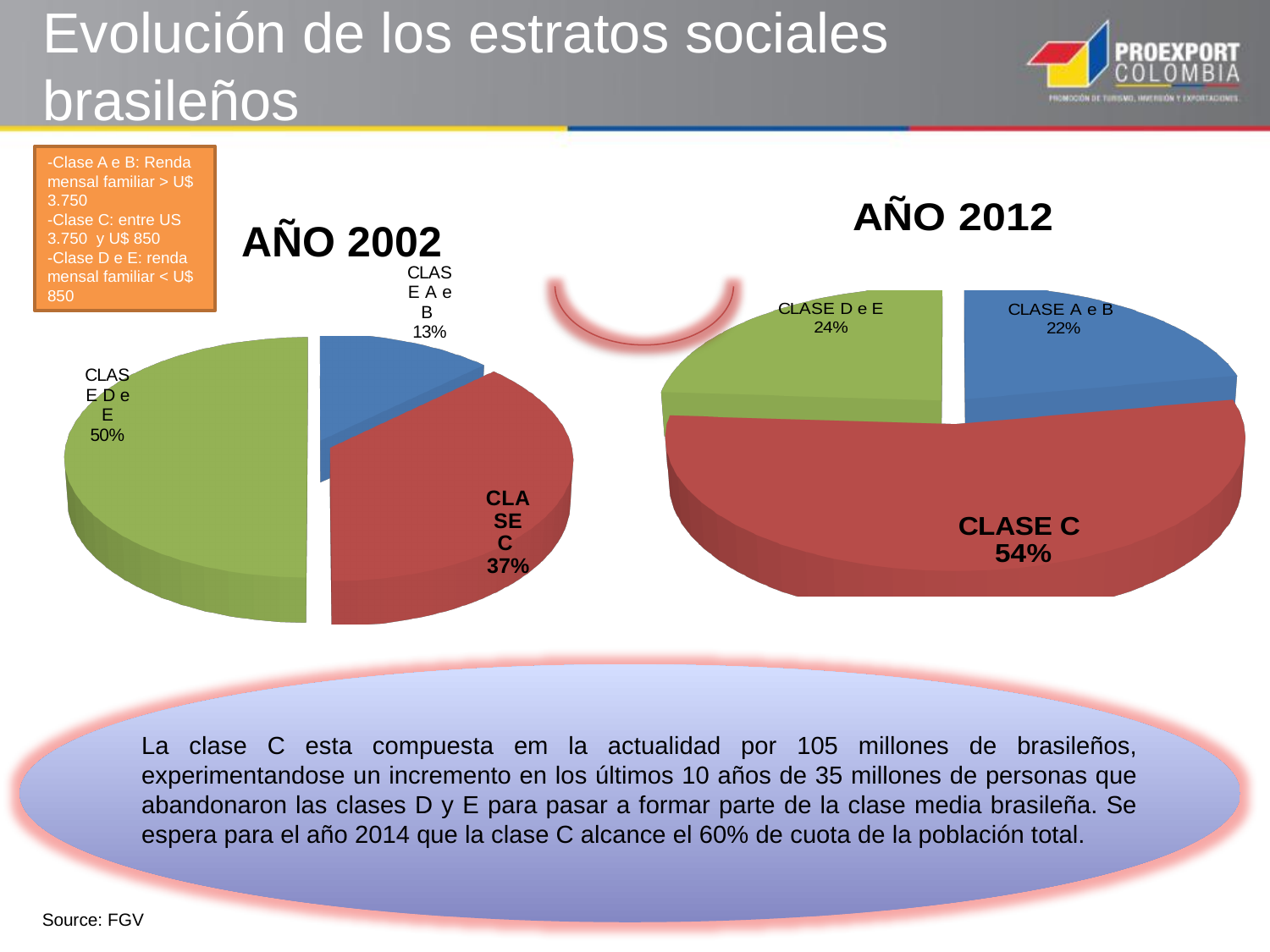
What is the difference in percentage points between the CLASE C share in the AÑO 2012 chart and in the AÑO 2002 chart? 17 In the AÑO 2002 pie chart, what share does CLASE C have? 37% In the AÑO 2012 pie chart, what share does CLASE C have? 54% What type of chart is used for AÑO 2012? Pie chart In the AÑO 2012 pie chart, which class has the smallest share? CLASE A e B In the AÑO 2012 pie chart, what share does CLASE A e B have? 22% In the AÑO 2002 pie chart, what share does CLASE D e E have? 50% In the AÑO 2012 pie chart, what share does CLASE D e E have? 24% In the AÑO 2012 pie chart, which is larger: the share of CLASE D e E or the share of CLASE A e B? CLASE D e E In the AÑO 2002 pie chart, which class has the largest share? CLASE D e E In the AÑO 2002 pie chart, what share does CLASE A e B have? 13% How many slices does the AÑO 2002 pie chart have? 3